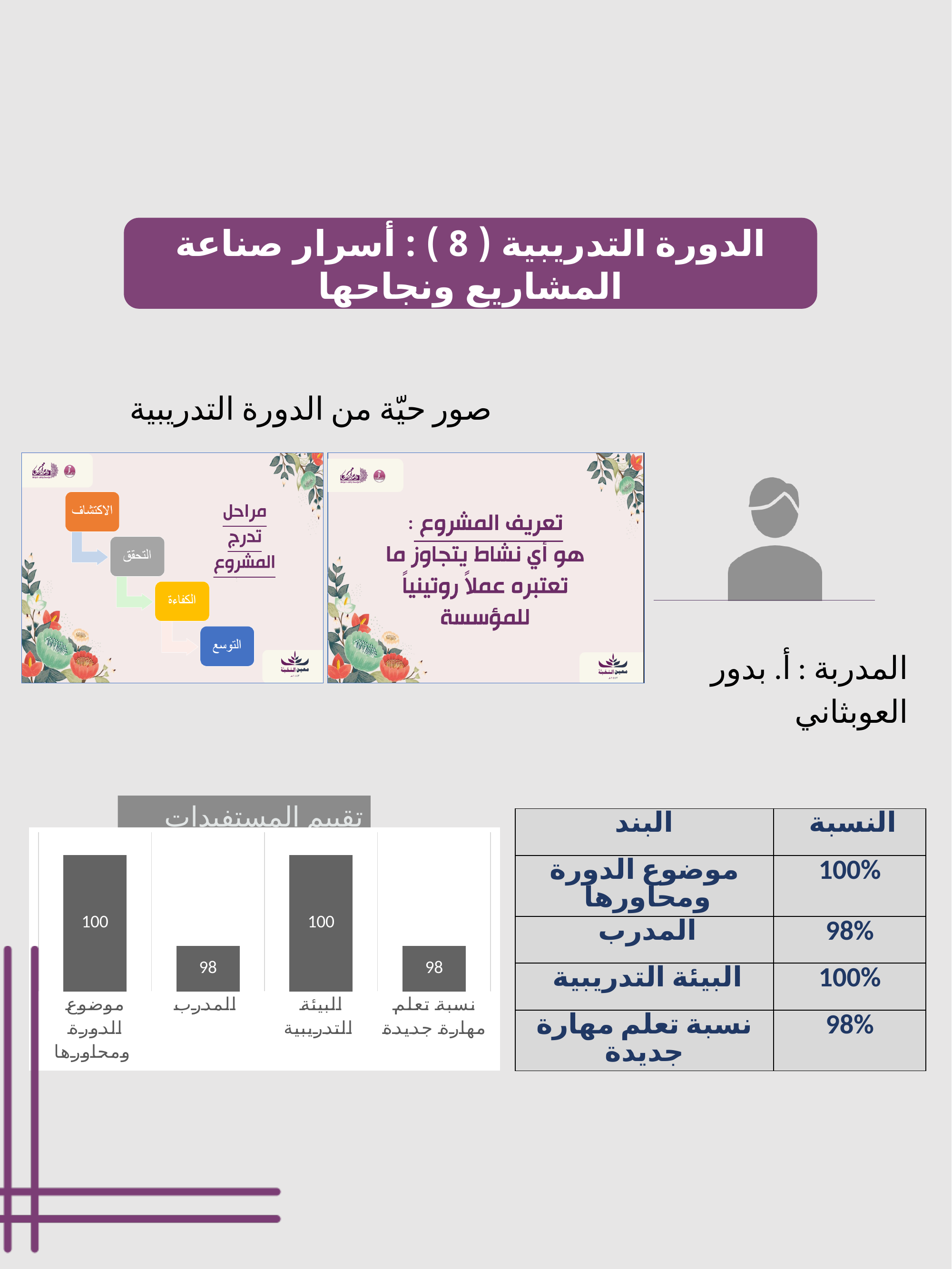
What colour are the bars in the تقييم المستفيدات chart? Dark grey What type of chart is shown under the title تقييم المستفيدات? Bar chart In the تقييم المستفيدات chart, which is larger: the value for نسبة تعلم مهارة جديدة or the value for البيئة التدريبية? البيئة التدريبية In the تقييم المستفيدات chart, what is the value for المدرب? 98 In the تقييم المستفيدات chart, what is the difference between the value for موضوع الدورة ومحاورها and the value for نسبة تعلم مهارة جديدة? 2 What is the title of the bar chart on the slide? تقييم المستفيدات How many categories are plotted in the تقييم المستفيدات chart? 4 In the تقييم المستفيدات chart, what is the value for البيئة التدريبية? 100 In the تقييم المستفيدات chart, what is the value for نسبة تعلم مهارة جديدة? 98 In the تقييم المستفيدات chart, which is larger: the value for موضوع الدورة ومحاورها or the value for المدرب? موضوع الدورة ومحاورها In the تقييم المستفيدات chart, what is the value for موضوع الدورة ومحاورها? 100 In the تقييم المستفيدات chart, what is the difference between the value for البيئة التدريبية and the value for المدرب? 2